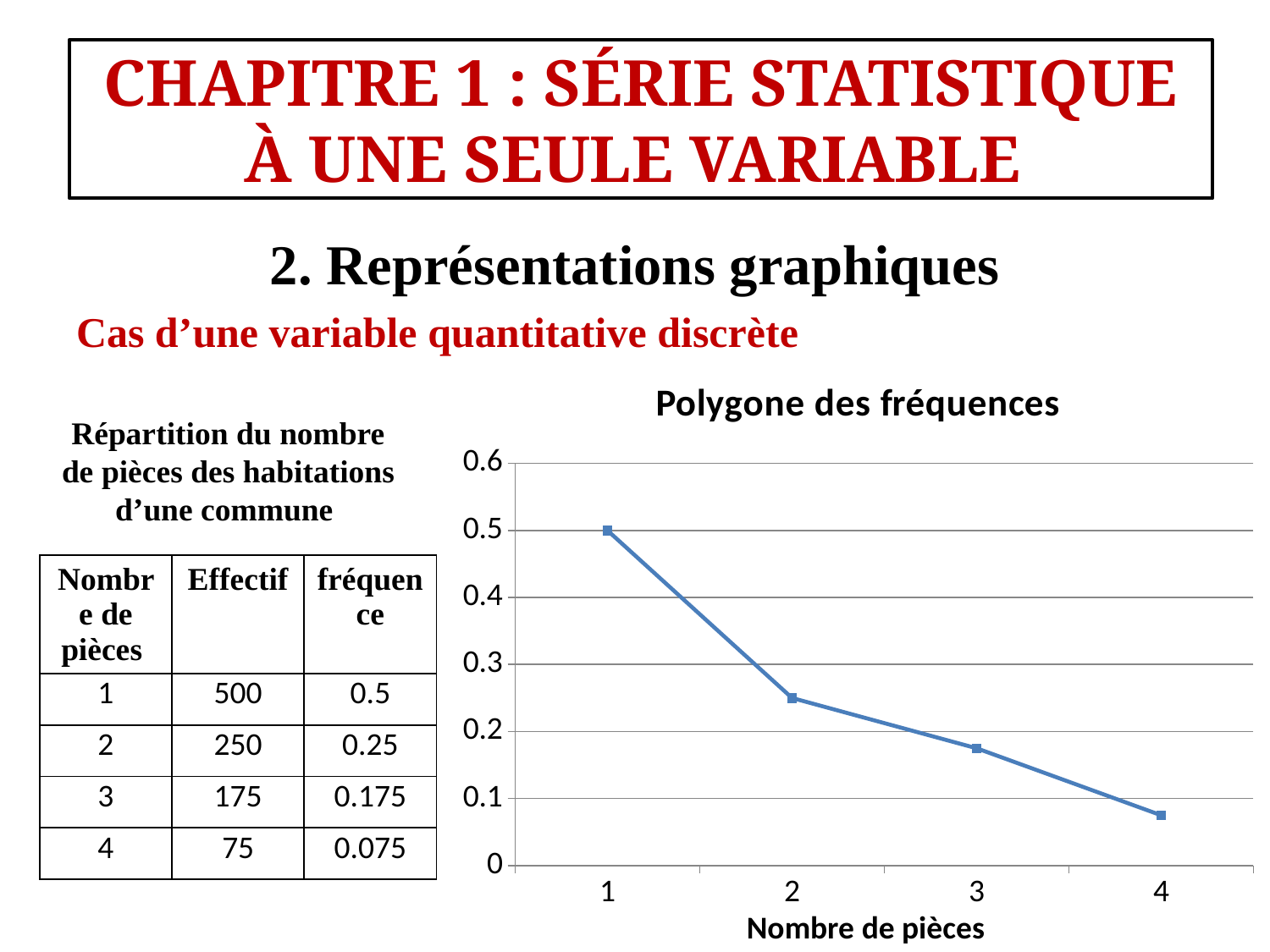
What kind of chart is shown on the slide? line chart What is the frequency value plotted for 1 piece? 0.5 Is the frequency for 3 pieces greater or less than 0.2? less Do the frequency values rise or fall as the number of pieces increases along the x axis? fall Which number of pieces has the lowest frequency on the chart? 4 What is the frequency value plotted for 4 pieces? 0.075 What is the frequency value plotted for 2 pieces? 0.25 What is the title of the chart? Polygone des fréquences Which number of pieces has the highest frequency on the chart? 1 Which has a larger frequency, 2 pieces or 3 pieces? 2 pieces What is the label of the x axis of the chart? Nombre de pièces How many data points are plotted on the chart? 4